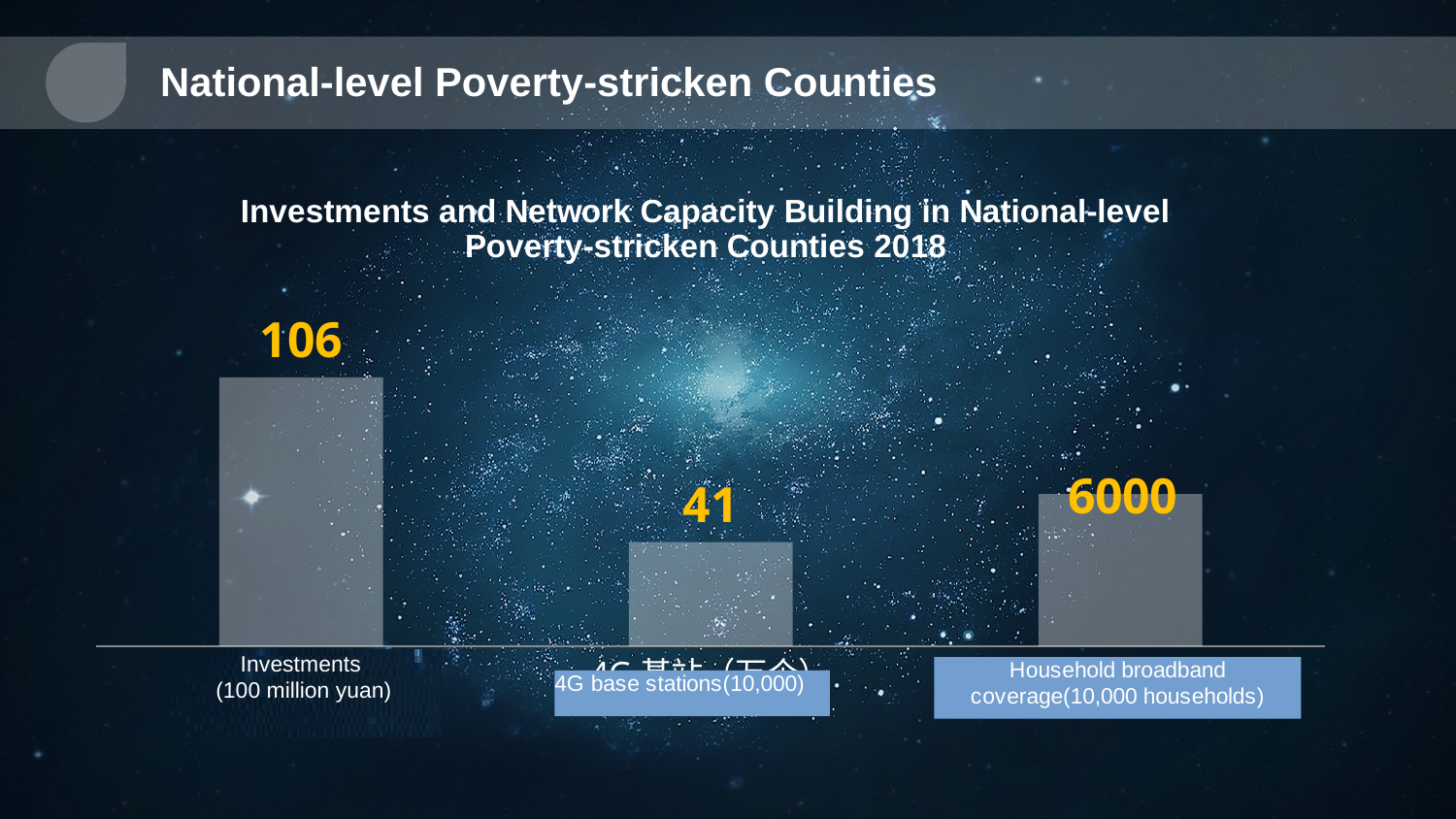
What kind of chart is shown on the slide? Bar chart What is the value shown for Investments (100 million yuan)? 106 Which category has the smallest data label value? 4G base stations (10,000) What is the value shown for 4G base stations (10,000)? 41 What is the difference between the Investments value and the 4G base stations value? 65 Which has the larger labeled value, Investments or 4G base stations? Investments Which category has the largest data label value? Household broadband coverage (10,000 households) Which bar is drawn the tallest on the slide? Investments (100 million yuan) What is the title of the chart? Investments and Network Capacity Building in National-level Poverty-stricken Counties 2018 What is the value shown for Household broadband coverage (10,000 households)? 6000 Is the value for 4G base stations greater or less than 50? less How many bars are shown in the chart? 3